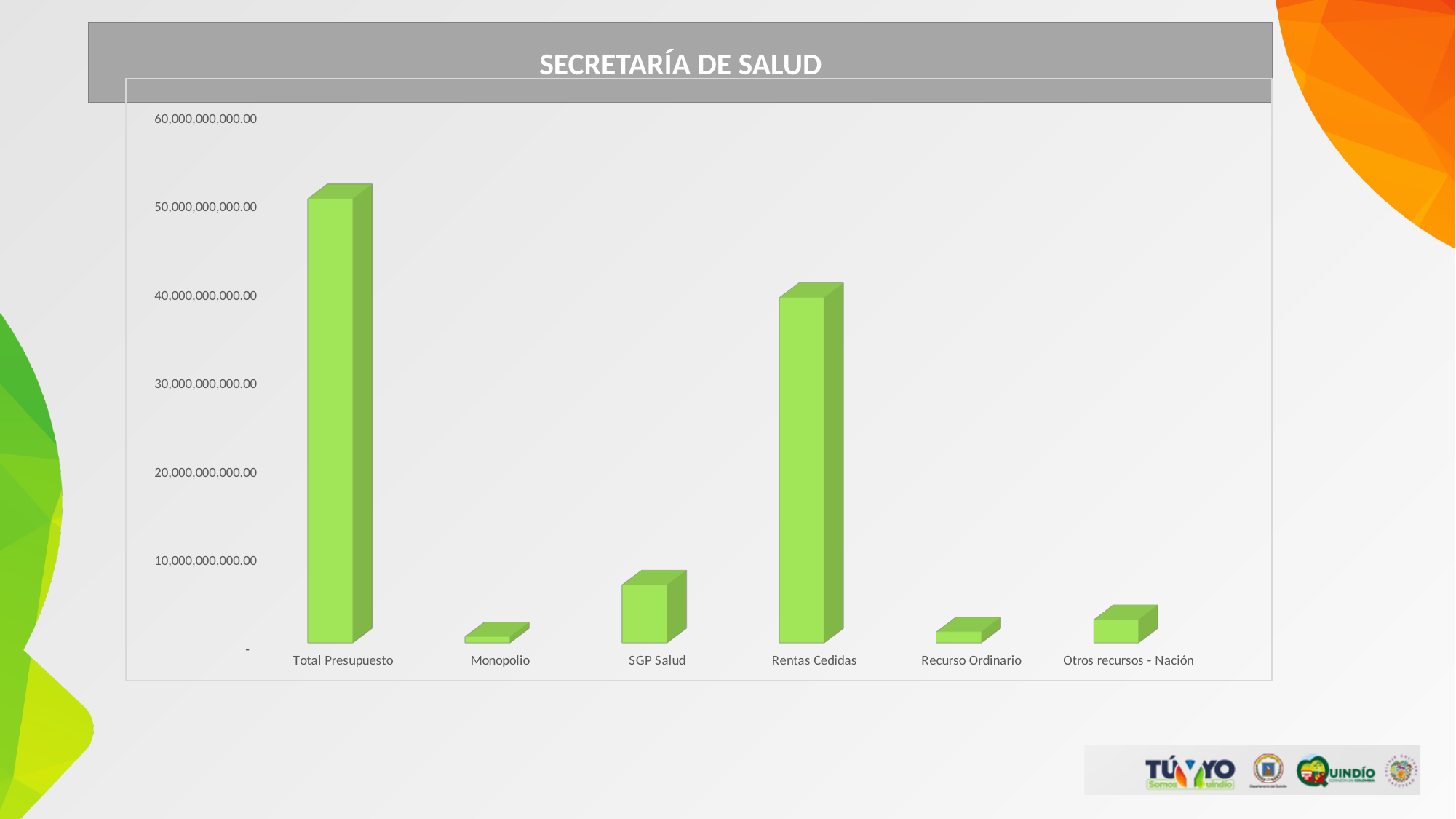
What is the title shown above the chart? SECRETARÍA DE SALUD Which is larger, the value for Total Presupuesto or the value for Rentas Cedidas? Total Presupuesto What is the highest value shown on the vertical axis of the chart? 60,000,000,000.00 Is the value for Rentas Cedidas greater or less than 30,000,000,000.00? greater Which category has the highest value in the chart? Total Presupuesto Is the value for SGP Salud greater or less than 10,000,000,000.00? less How many categories are plotted on the x axis of the chart? 6 Which is larger, the value for Otros recursos - Nación or the value for Monopolio? Otros recursos - Nación Which is larger, the value for SGP Salud or the value for Monopolio? SGP Salud What kind of chart is shown on the slide? bar chart Is the value for Total Presupuesto greater or less than 40,000,000,000.00? greater